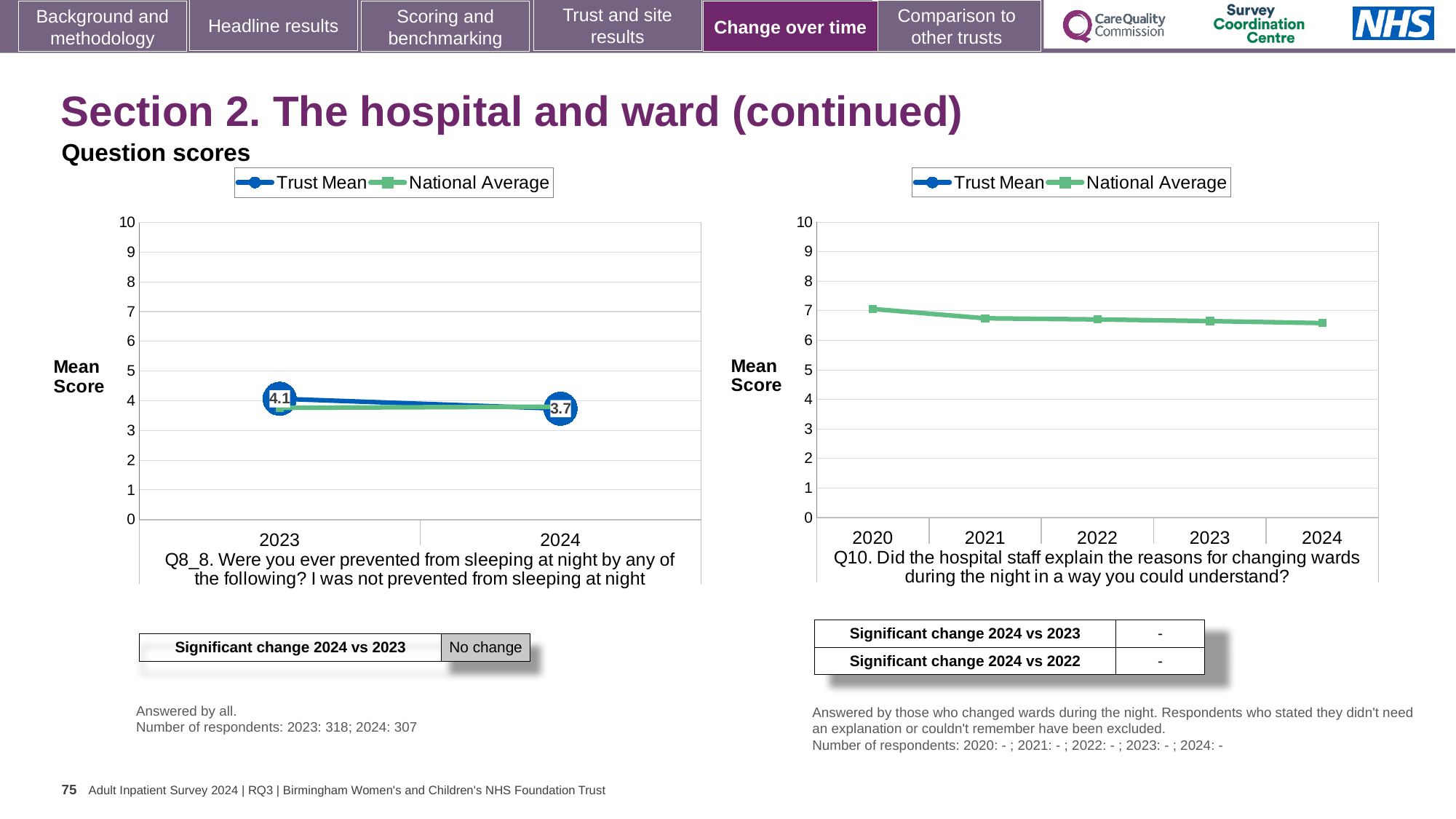
How many years are shown on the x axis of the Q8_8 chart on the left? 2 In the Q10 chart on the right, is the National Average for 2024 greater or less than 7? less How many years are shown on the x axis of the Q10 chart on the right? 5 In the Q8_8 chart on the left, which year has the higher Trust Mean, 2023 or 2024? 2023 In the Q8_8 chart on the left, by how much did the Trust Mean change from 2023 to 2024? 0.4 In the Q8_8 chart on the left, what is the Trust Mean for 2024? 3.7 In the Q10 chart on the right, does the National Average rise or fall from 2020 to 2024? fall In the Q10 chart on the right, is the National Average for 2020 greater or less than 6? greater In the Q8_8 chart on the left, what is the Trust Mean for 2023? 4.1 In the Q8_8 chart on the left, does the Trust Mean rise or fall from 2023 to 2024? fall What kind of chart is the Q8_8 chart on the left? line chart How many series does the legend of the Q8_8 chart on the left list? 2